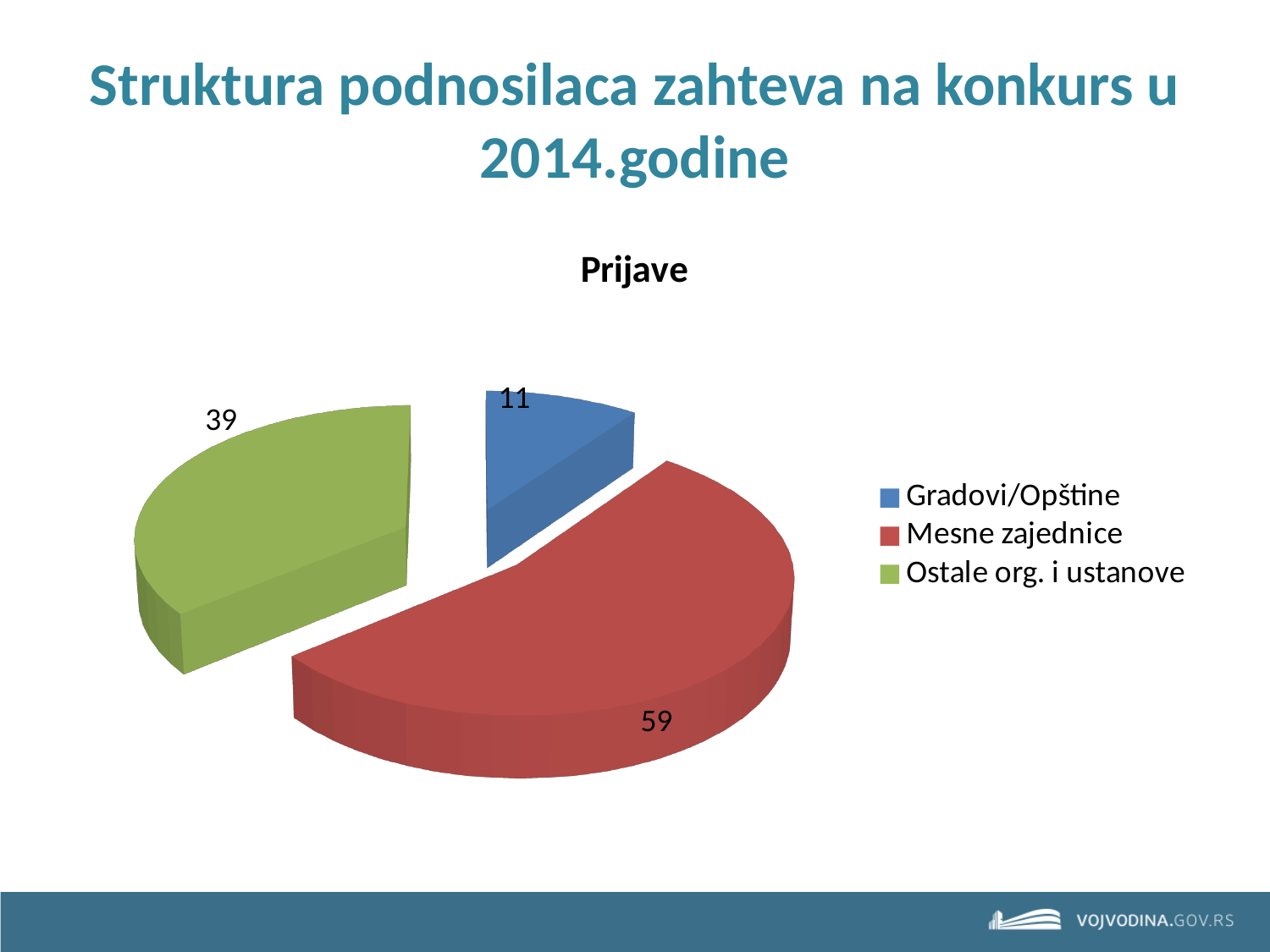
What type of chart is shown on the slide? pie chart How many slices does the pie chart have? 3 What is the value for Gradovi/Opštine? 11 Which category has the smallest slice? Gradovi/Opštine Which category has the largest slice? Mesne zajednice What is the difference between the values for Mesne zajednice and Ostale org. i ustanove? 20 What is the value for Ostale org. i ustanove? 39 What colour is the slice for Mesne zajednice? red Which is larger, the value for Ostale org. i ustanove or the value for Gradovi/Opštine? Ostale org. i ustanove What is the value for Mesne zajednice? 59 How many entries does the legend list? 3 What is the title of the chart? Prijave